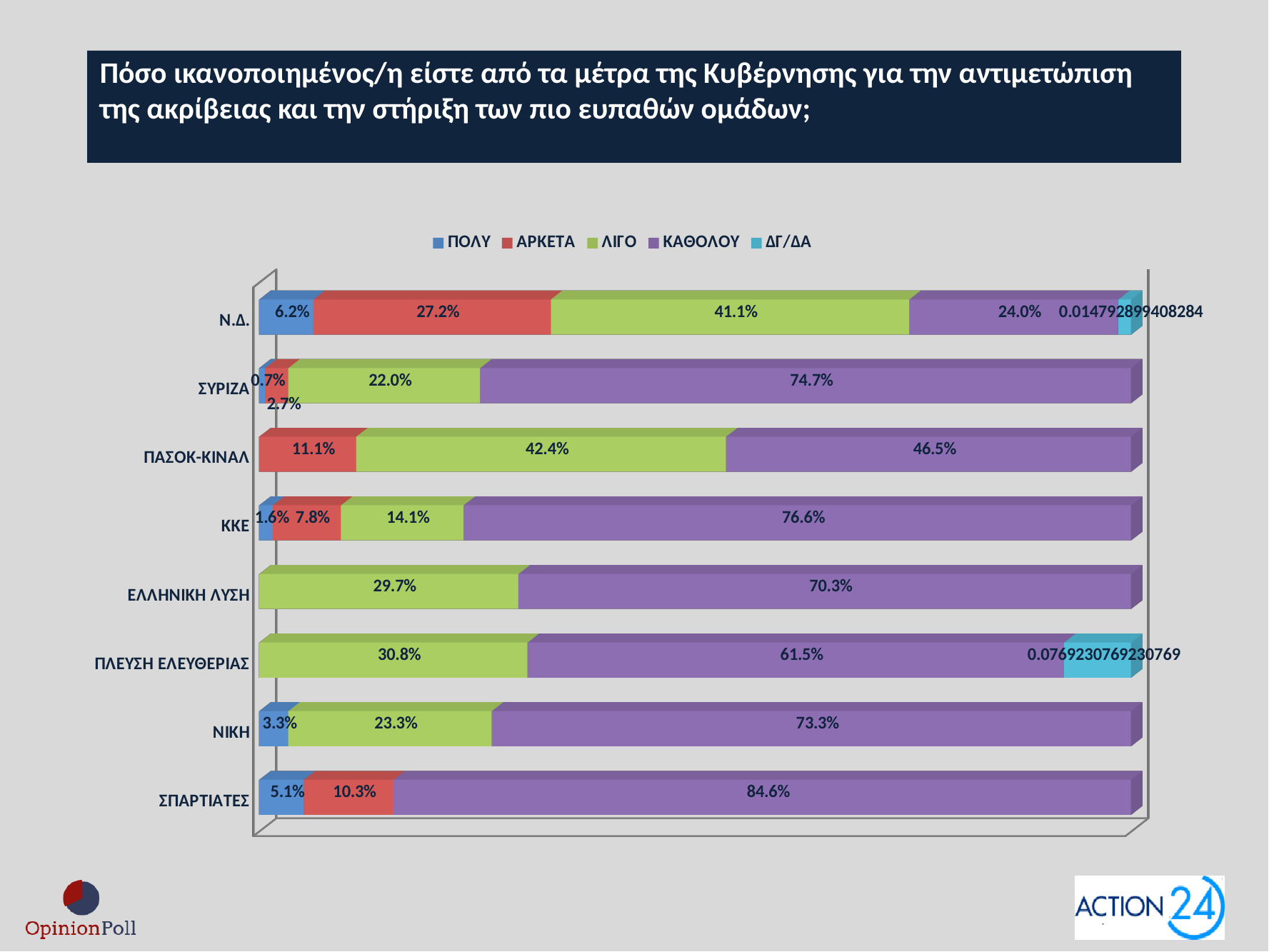
What is the difference between the ΚΑΘΟΛΟΥ value for ΚΚΕ and the ΚΑΘΟΛΟΥ value for ΕΛΛΗΝΙΚΗ ΛΥΣΗ? 6.3% What is the ΚΑΘΟΛΟΥ value for ΣΥΡΙΖΑ? 74.7% Which is larger: the ΛΙΓΟ value for ΠΑΣΟΚ-ΚΙΝΑΛ or the ΛΙΓΟ value for ΠΛΕΥΣΗ ΕΛΕΥΘΕΡΙΑΣ? ΠΑΣΟΚ-ΚΙΝΑΛ Which category has the lowest ΚΑΘΟΛΟΥ value? Ν.Δ. What is the ΠΟΛΥ value for ΣΠΑΡΤΙΑΤΕΣ? 5.1% What kind of chart is shown on the slide? Stacked bar chart What is the ΑΡΚΕΤΑ value for ΠΑΣΟΚ-ΚΙΝΑΛ? 11.1% Which category has the highest ΚΑΘΟΛΟΥ value? ΣΠΑΡΤΙΑΤΕΣ How many series does the legend list? 5 How many categories (parties) are shown on the chart? 8 What is the ΛΙΓΟ value for Ν.Δ.? 41.1% What is the total of the ΛΙΓΟ and ΚΑΘΟΛΟΥ values for ΕΛΛΗΝΙΚΗ ΛΥΣΗ? 100.0%